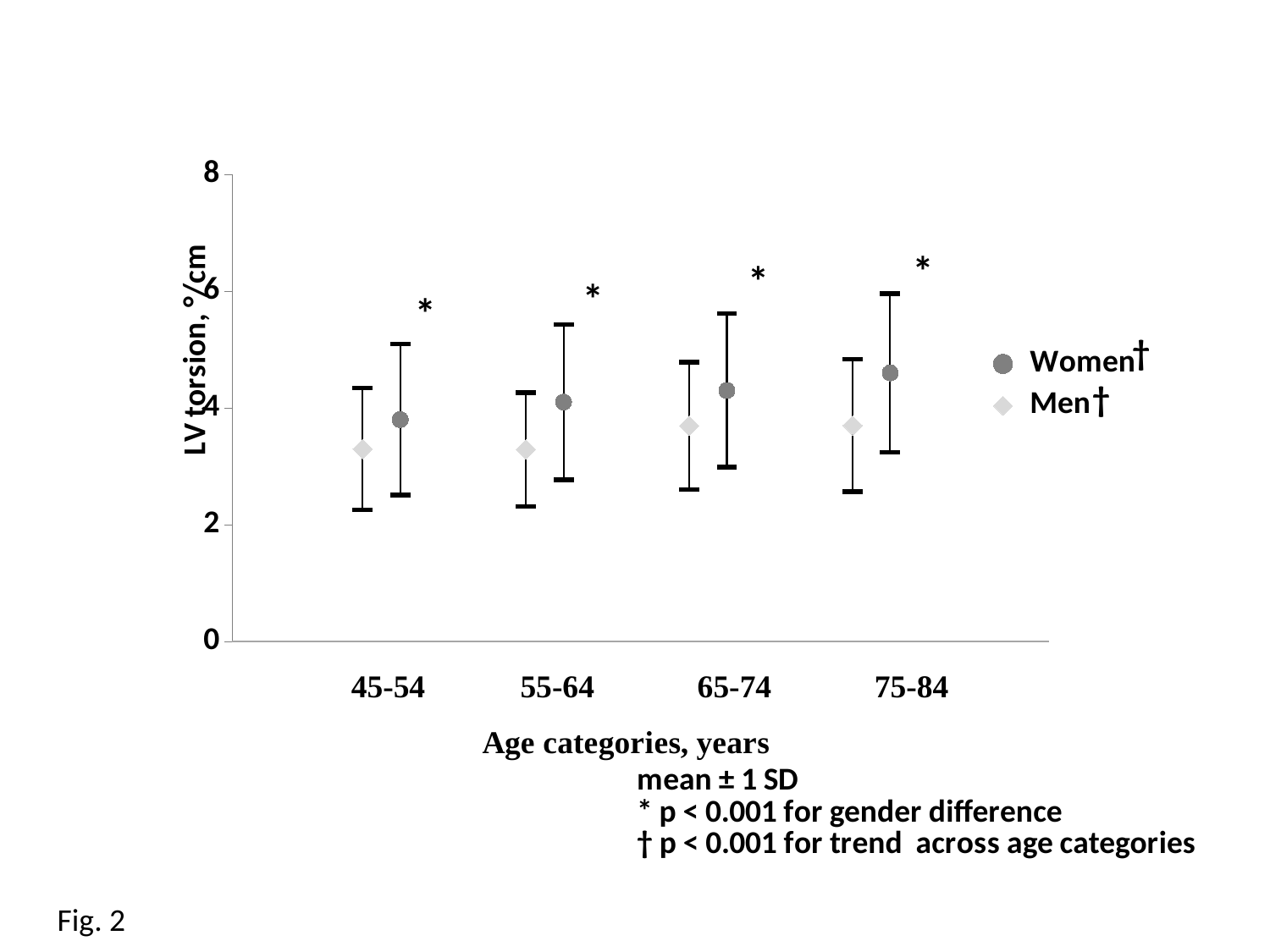
How many age categories are shown on the x axis? 4 In the 75-84 age category, which series has the larger mean LV torsion, Women or Men? Women What is the label of the x axis? Age categories, years Is the mean value for Men in the 45-54 age category greater or less than 4? less What is the label of the y axis? LV torsion, °/cm Is the mean value for Women in the 75-84 age category greater or less than 4? greater Which age category has the highest mean LV torsion for Women? 75-84 How many series does the legend list? 2 Is the mean value for Men in the 75-84 age category greater or less than 4? less Do the mean values for Women rise or fall across the age categories from 45-54 to 75-84? rise What kind of chart is this? scatter chart with error bars Which age category has the lowest mean LV torsion for Women? 45-54